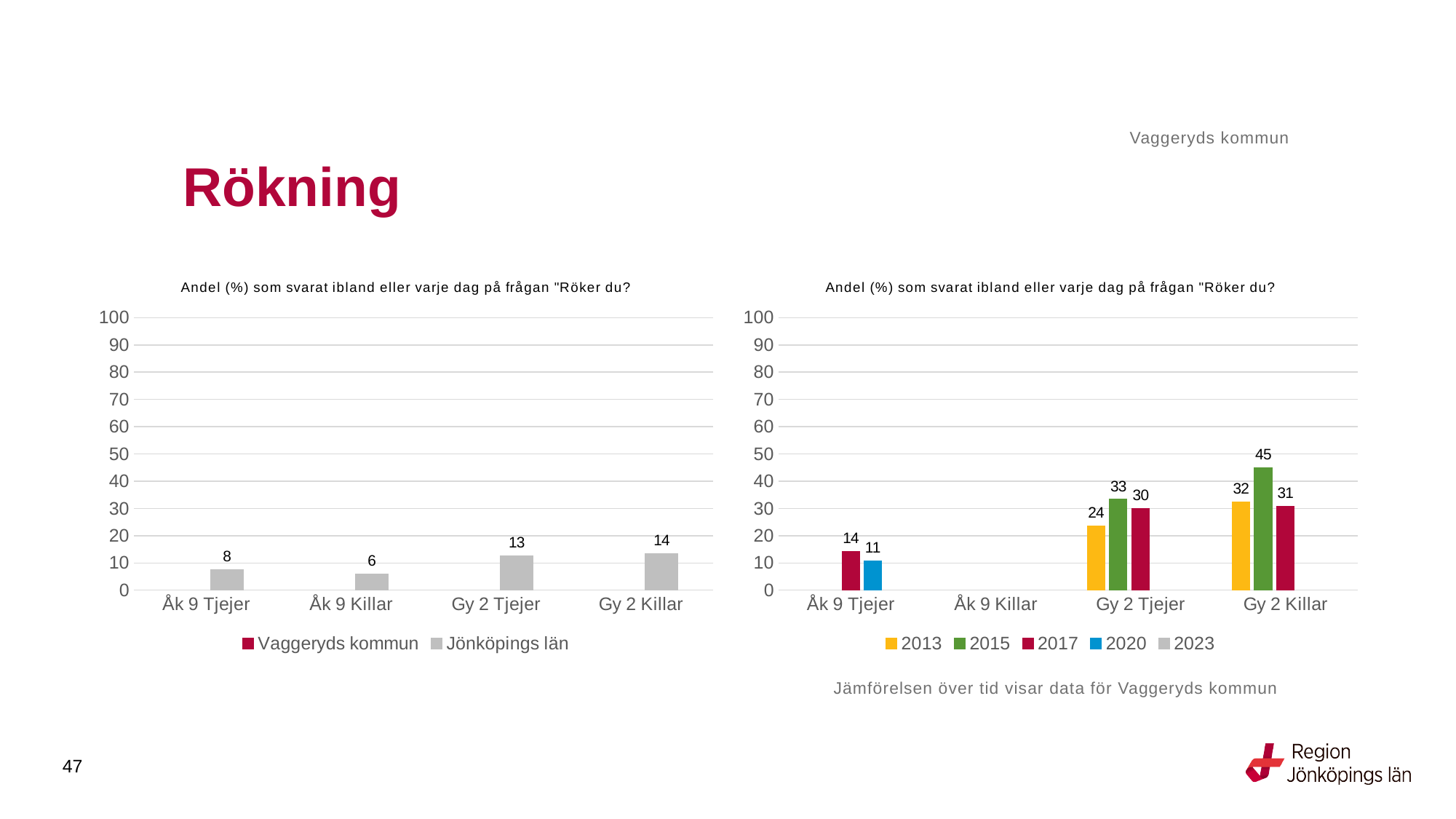
In the right chart, what is the difference between the 2015 and 2013 values for Gy 2 Killar? 13 In the right chart, what is the value for 2020 for Åk 9 Tjejer? 11 In the left chart, which category has the highest value for Jönköpings län? Gy 2 Killar In the left chart, how many series does the legend list? 2 In the right chart, what is the value for 2015 for Gy 2 Killar? 45 In the right chart, how many series does the legend list? 5 In the right chart, which is larger for Gy 2 Tjejer: the 2013 value or the 2017 value? 2017 In the right chart, which year has the highest value for Gy 2 Tjejer? 2015 In the left chart, what is the value for Jönköpings län for Gy 2 Tjejer? 13 In the left chart, what is the difference between the Jönköpings län values for Gy 2 Killar and Åk 9 Tjejer? 6 What kind of chart is the right chart? Bar chart In the left chart, which category has the lowest value for Jönköpings län? Åk 9 Killar